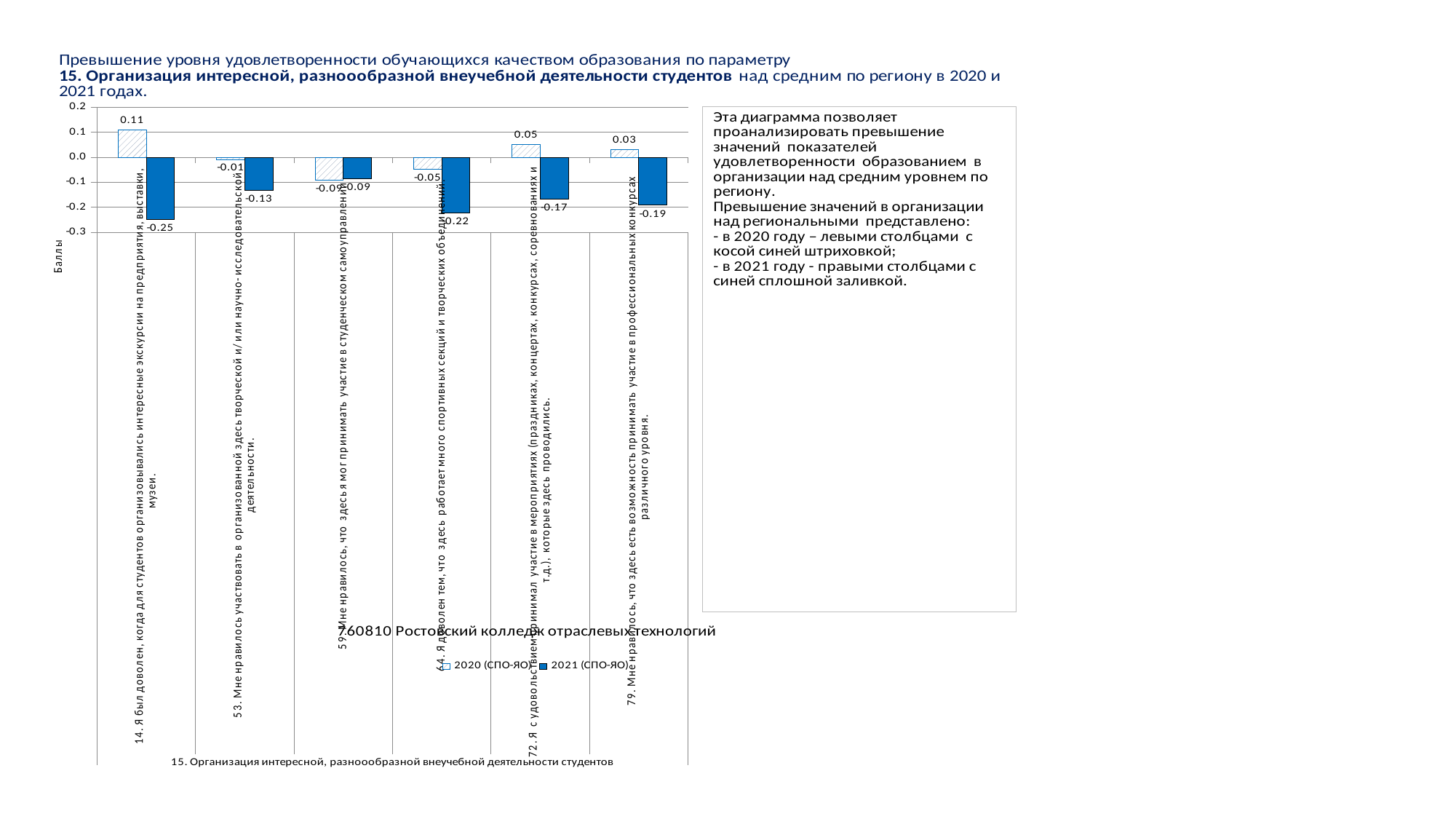
What kind of chart is shown on the slide? bar chart What is the 2020 (СПО-ЯО) value for category 79 (Мне нравилось, что здесь есть возможность принимать участие в профессиональных конкурсах различного уровня)? 0.03 What is the 2021 (СПО-ЯО) value for category 64 (Я доволен тем, что здесь работает много спортивных секций и творческих объединений)? -0.22 For category 53 (Мне нравилось участвовать в организованной здесь творческой и/или научно-исследовательской деятельности), which series has the larger value, 2020 (СПО-ЯО) or 2021 (СПО-ЯО)? 2020 (СПО-ЯО) Which category has the lowest 2021 (СПО-ЯО) value? 14. Я был доволен, когда для студентов организовывались интересные экскурсии на предприятия, выставки, музеи. Which category has the highest 2020 (СПО-ЯО) value? 14. Я был доволен, когда для студентов организовывались интересные экскурсии на предприятия, выставки, музеи. What is the 2021 (СПО-ЯО) value for category 14 (Я был доволен, когда для студентов организовывались интересные экскурсии на предприятия, выставки, музеи)? -0.25 How many series does the chart legend list? 2 What is the difference between the 2020 (СПО-ЯО) and 2021 (СПО-ЯО) values for category 72 (Я с удовольствием принимал участие в мероприятиях)? 0.22 How many categories (questions) are plotted on the x axis of the chart? 6 What is the 2020 (СПО-ЯО) value for category 14 (Я был доволен, когда для студентов организовывались интересные экскурсии на предприятия, выставки, музеи)? 0.11